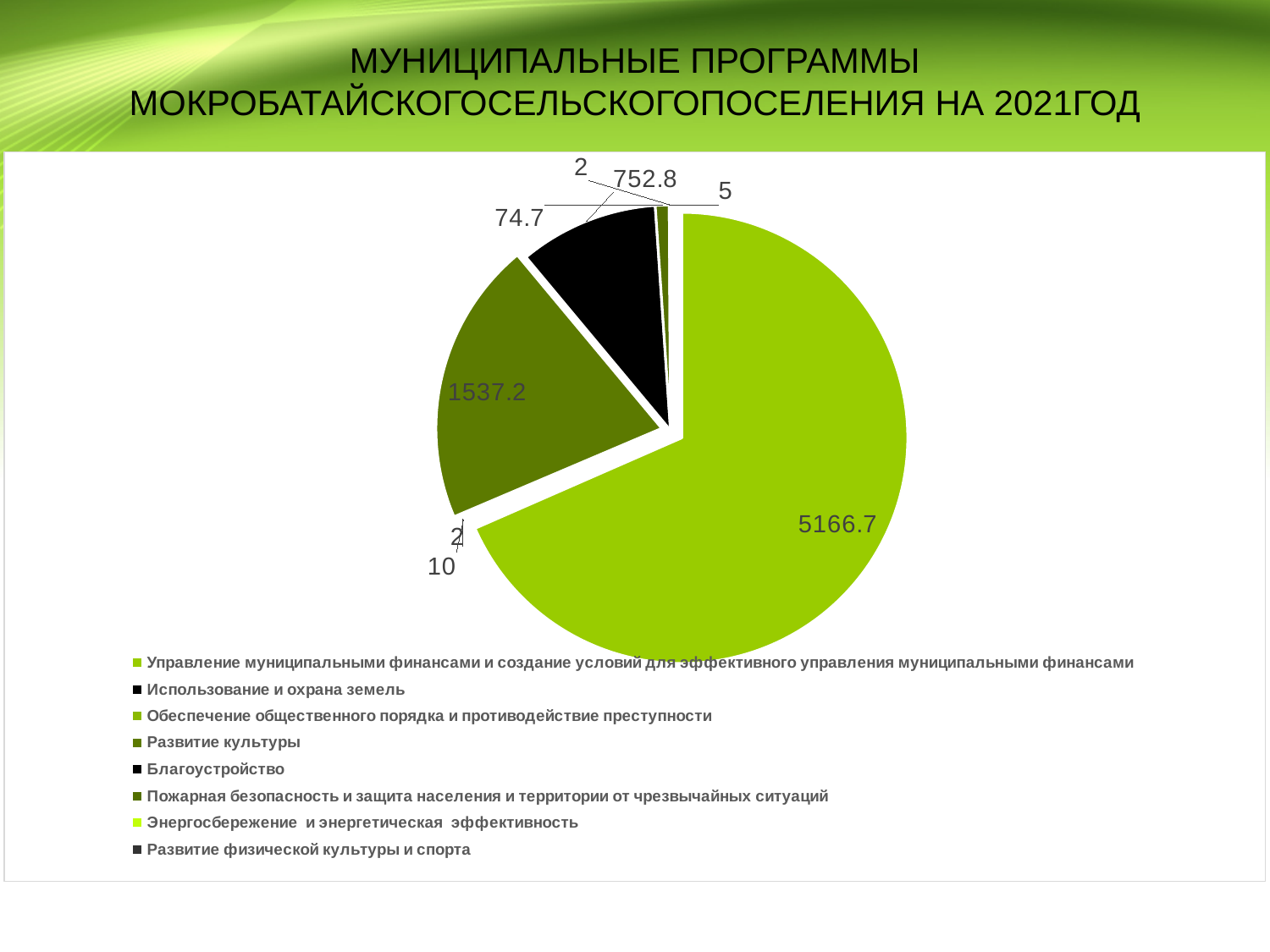
How many entries does the legend of the pie chart list? 8 How many data labels are shown on the pie chart? 8 What is the value labelled on the black slice of the pie chart? 752.8 What year does the slide title say the municipal programmes are for? 2021 Which programme has the largest slice in the pie chart? Управление муниципальными финансами и создание условий для эффективного управления муниципальными финансами What is the value labelled on the second-largest slice of the pie chart? 1537.2 What is the difference between the slice labelled 752.8 and the slice labelled 74.7? 678.1 What type of chart is shown on the slide? pie chart What is the smallest value labelled on the pie chart? 2 Which is larger: the slice labelled 1537.2 or the slice labelled 752.8? 1537.2 What is the difference between the slice labelled 5166.7 and the slice labelled 1537.2? 3629.5 What is the value of the largest slice of the pie chart? 5166.7